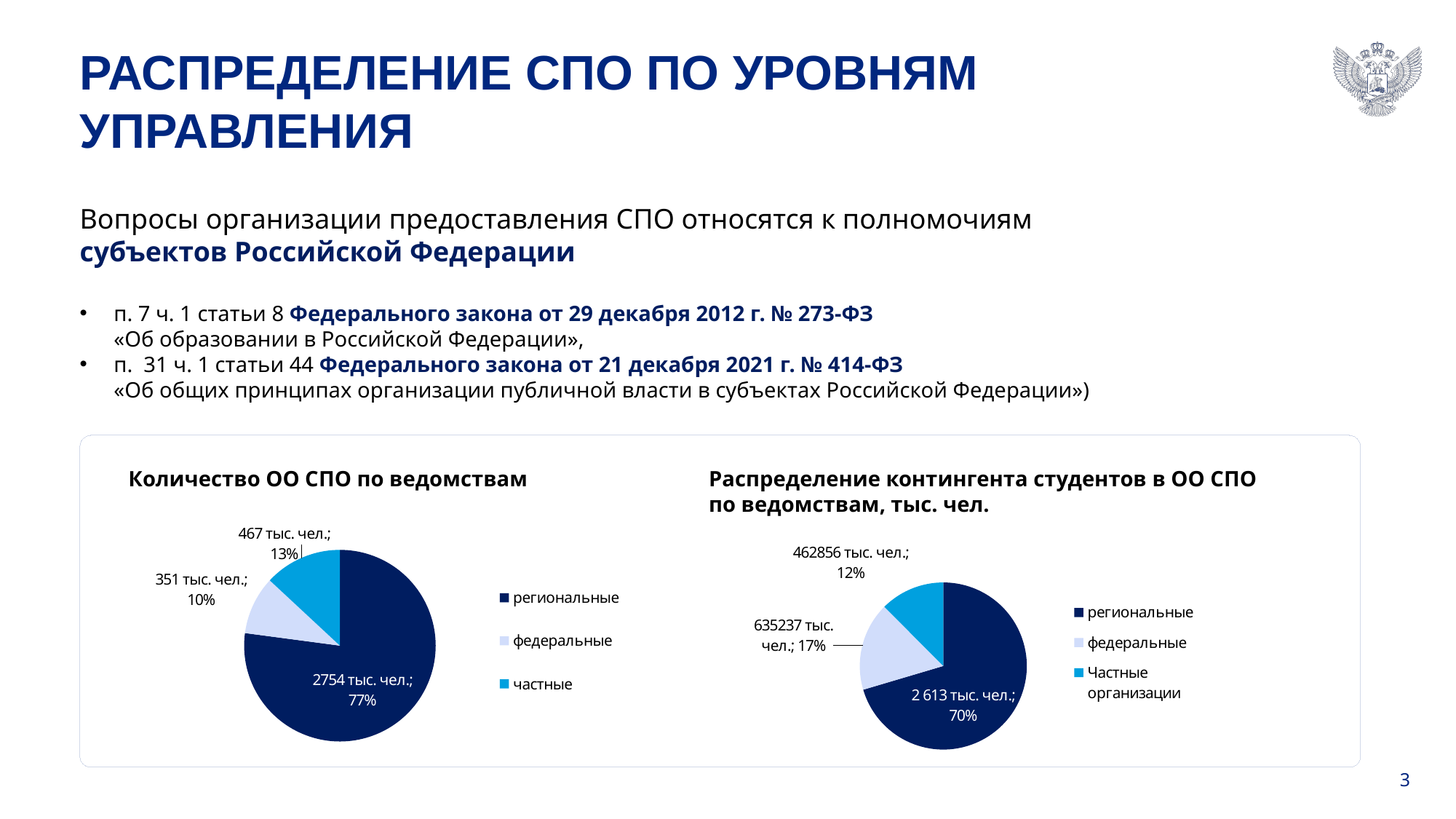
How many slices does the pie chart 'Количество ОО СПО по ведомствам' have? 3 What type of chart is 'Количество ОО СПО по ведомствам'? pie chart In the chart 'Распределение контингента студентов в ОО СПО по ведомствам, тыс. чел.', what share of the pie is 'Частные организации'? 12% In the chart 'Количество ОО СПО по ведомствам', what share of the pie is 'частные'? 13% In the chart 'Количество ОО СПО по ведомствам', which category has the smallest slice? федеральные In the chart 'Распределение контингента студентов в ОО СПО по ведомствам, тыс. чел.', which category has the largest slice? региональные In the chart 'Распределение контингента студентов в ОО СПО по ведомствам, тыс. чел.', which slice is larger: 'федеральные' or 'Частные организации'? федеральные How many entries does the legend of the chart 'Распределение контингента студентов в ОО СПО по ведомствам, тыс. чел.' list? 3 In the chart 'Распределение контингента студентов в ОО СПО по ведомствам, тыс. чел.', what value is shown for 'федеральные'? 635237 тыс. чел. In the chart 'Количество ОО СПО по ведомствам', what share of the pie is 'региональные'? 77% In the chart 'Количество ОО СПО по ведомствам', what value is shown for 'федеральные'? 351 тыс. чел.